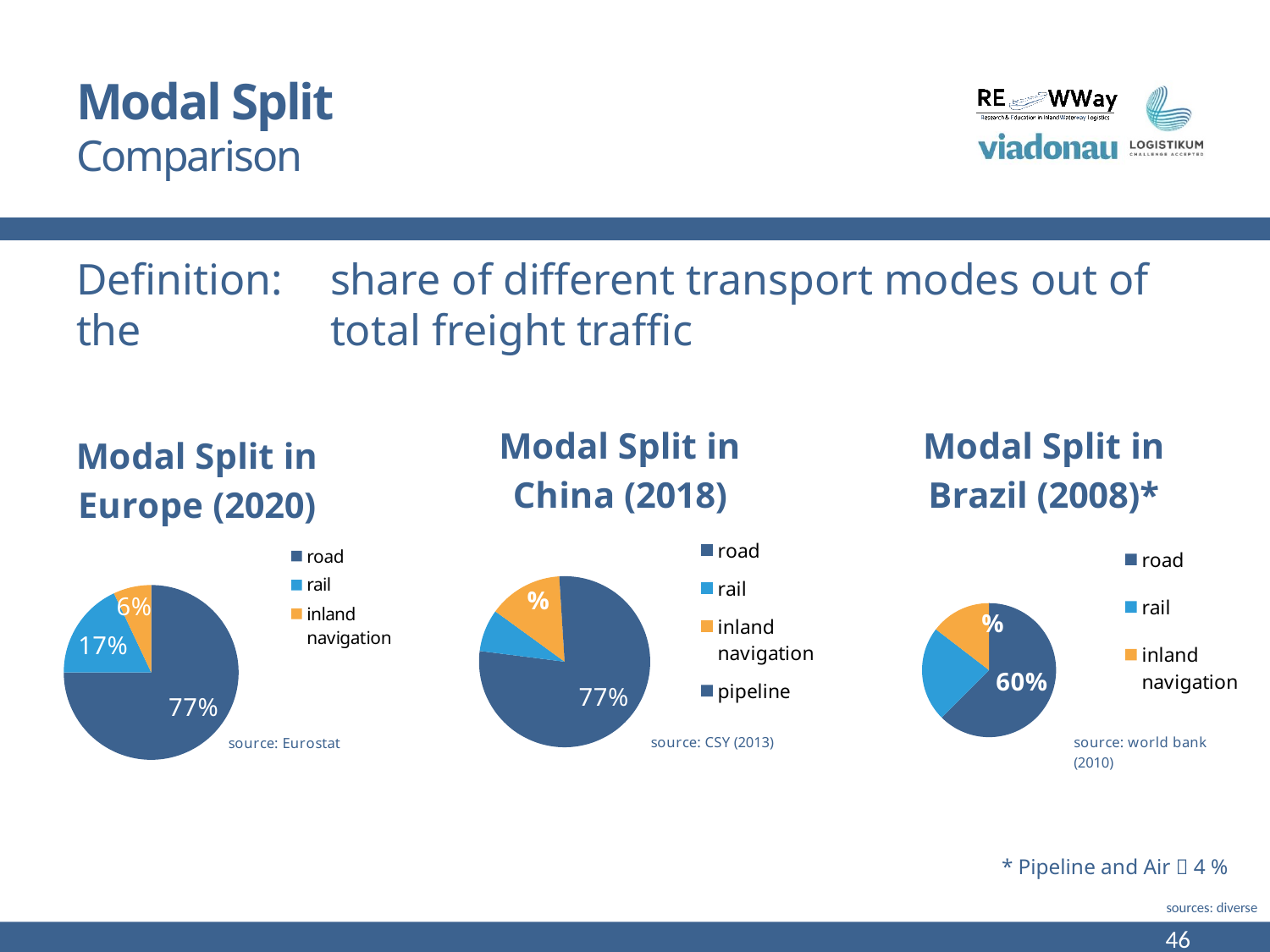
In the Modal Split in Europe (2020) chart, which transport mode has the largest share? road In the Modal Split in Europe (2020) chart, what share does inland navigation have? 6% In the Modal Split in Europe (2020) chart, what share does road have? 77% In the Modal Split in Europe (2020) chart, which is larger, the rail share or the inland navigation share? rail What kind of chart is the Modal Split in Brazil (2008)* chart? pie chart In the Modal Split in Brazil (2008)* chart, what share does road have? 60% Which legend entry appears in the Modal Split in China (2018) chart but not in the Europe or Brazil charts? pipeline In the Modal Split in Europe (2020) chart, what is the difference between the road share and the rail share? 60% How many entries does the legend of the Modal Split in China (2018) chart list? 4 In the Modal Split in Europe (2020) chart, which transport mode has the smallest share? inland navigation In the Modal Split in China (2018) chart, what share does road have? 77% In the Modal Split in Europe (2020) chart, what share does rail have? 17%